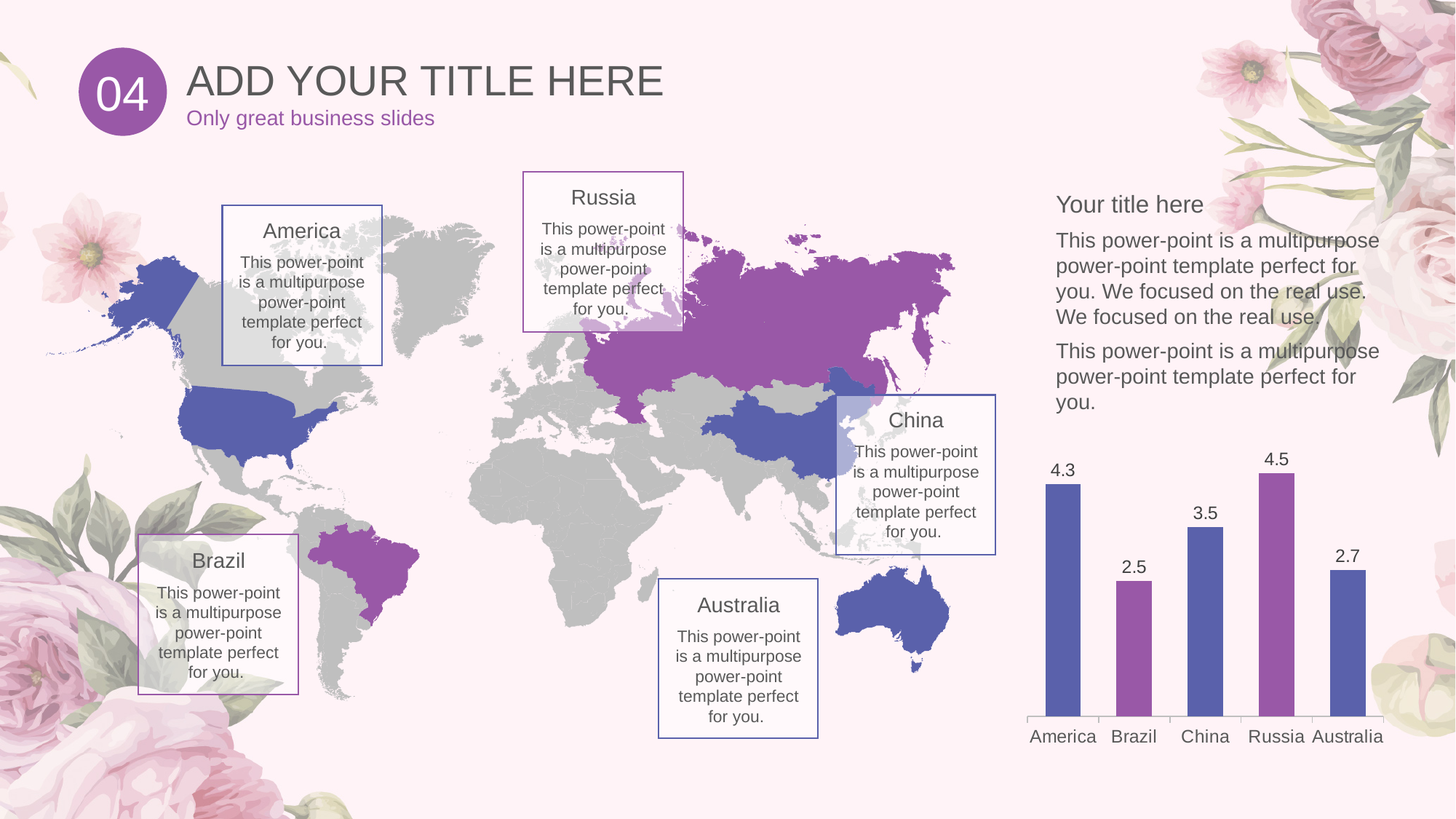
How many categories are shown in the bar chart? 5 What is the value for Brazil in the bar chart? 2.5 What kind of chart is shown on the right of the slide? Bar chart Which category has the highest value in the bar chart? Russia What is the difference between the values for Russia and Brazil in the bar chart? 2 Which category has the lowest value in the bar chart? Brazil What is the value for China in the bar chart? 3.5 What is the value for Australia in the bar chart? 2.7 What colour is the bar for Russia in the bar chart? Purple What is the difference between the values for America and China in the bar chart? 0.8 What is the value for America in the bar chart? 4.3 Which has a larger value in the bar chart, China or Australia? China